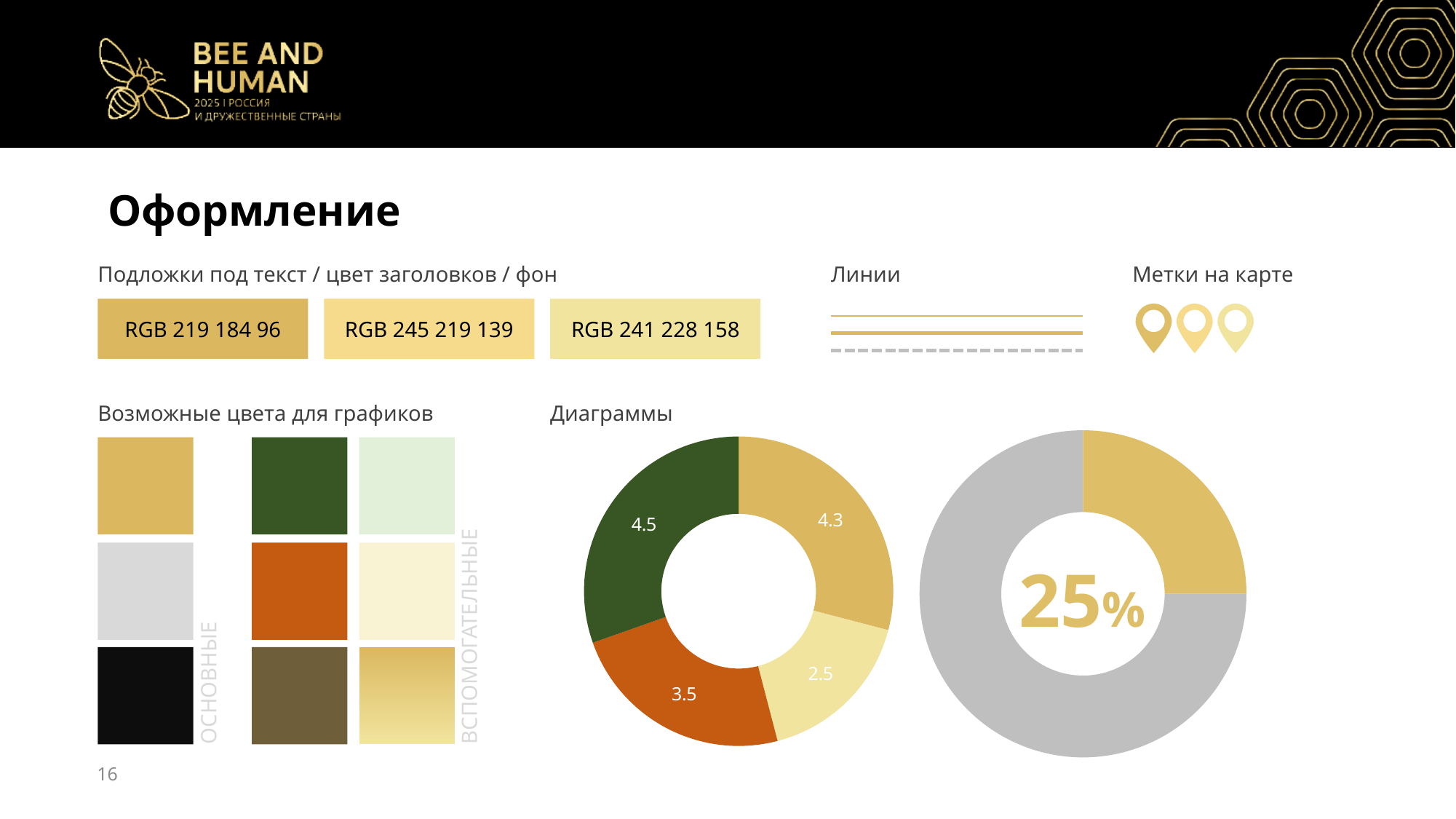
In the left donut chart, what value is shown on the gold slice? 4.3 In the left donut chart, what is the difference between the largest value (4.5) and the smallest value (2.5)? 2.0 In the right donut chart, what percentage is shown in the centre? 25% In the left donut chart, which slice has the highest value? The dark green slice (4.5) What type of chart is the left chart under "Диаграммы"? Donut (pie) chart How many slices does the left donut chart have? 4 In the left donut chart, what value is shown on the dark green slice? 4.5 In the left donut chart, which is larger: the gold slice or the orange slice? The gold slice (4.3) In the left donut chart, what value is shown on the light yellow slice? 2.5 How many segments does the right donut chart have? 2 In the left donut chart, which slice has the lowest value? The light yellow slice (2.5) In the left donut chart, what value is shown on the orange slice? 3.5